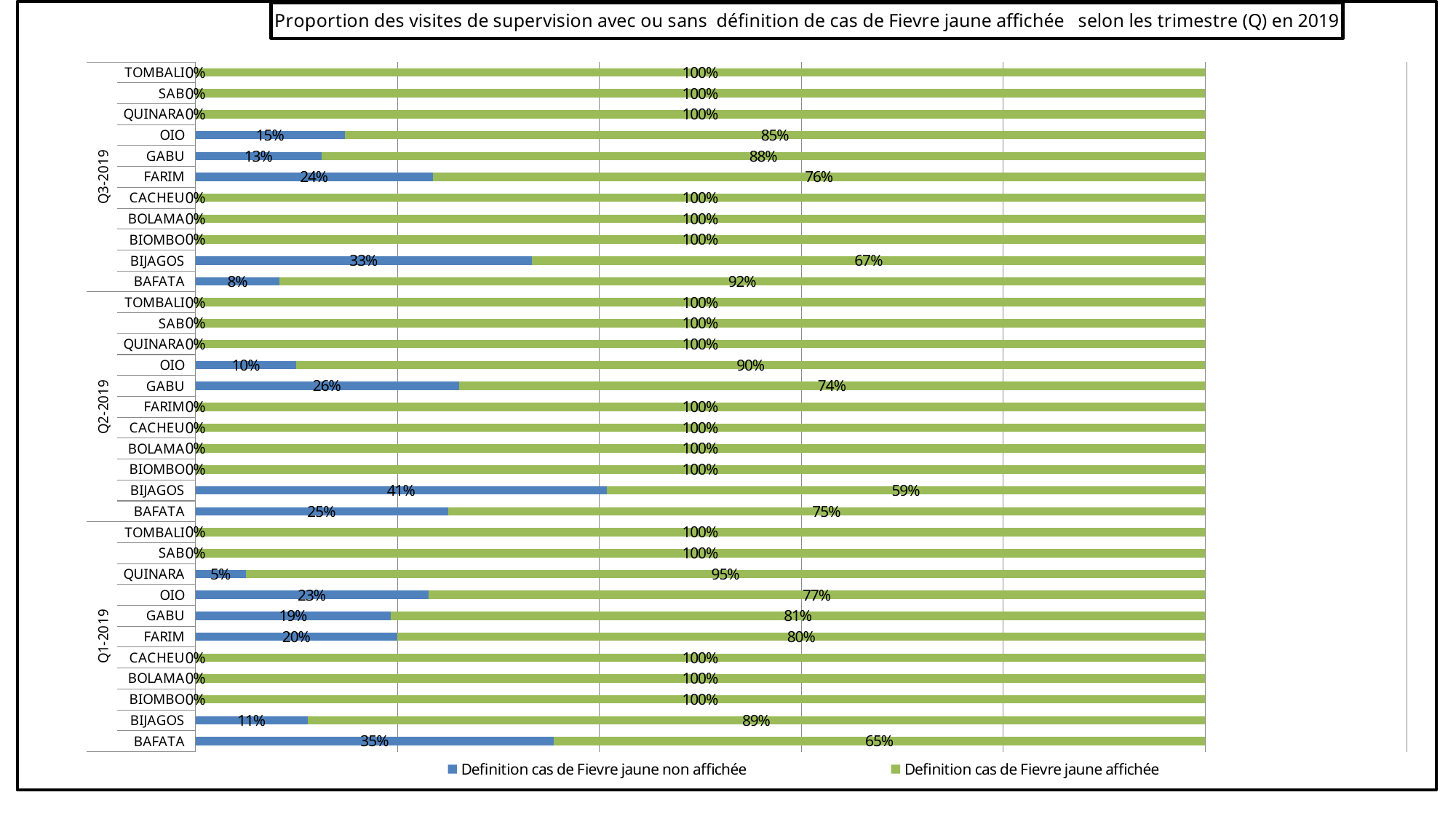
Which region and quarter has the lowest value for 'Definition cas de Fievre jaune affichée'? BIJAGOS, Q2-2019 (59%) What colour represents 'Definition cas de Fievre jaune non affichée' in the legend? Blue What is the value of 'Definition cas de Fievre jaune affichée' for FARIM in Q3-2019? 76% How many regions are listed within each quarter on the chart? 11 How many series does the legend list? 2 What is the value of 'Definition cas de Fievre jaune affichée' for QUINARA in Q1-2019? 95% What is the value of 'Definition cas de Fievre jaune non affichée' for BAFATA in Q1-2019? 35% In Q2-2019, which has the larger 'Definition cas de Fievre jaune non affichée' value, GABU or OIO? GABU What is the difference between the 'non affichée' value for BIJAGOS in Q3-2019 and in Q1-2019? 22 percentage points What kind of chart is shown on the slide? Bar chart What is the value of 'Definition cas de Fievre jaune non affichée' for BIJAGOS in Q2-2019? 41% Which region and quarter has the highest value for 'Definition cas de Fievre jaune non affichée'? BIJAGOS, Q2-2019 (41%)